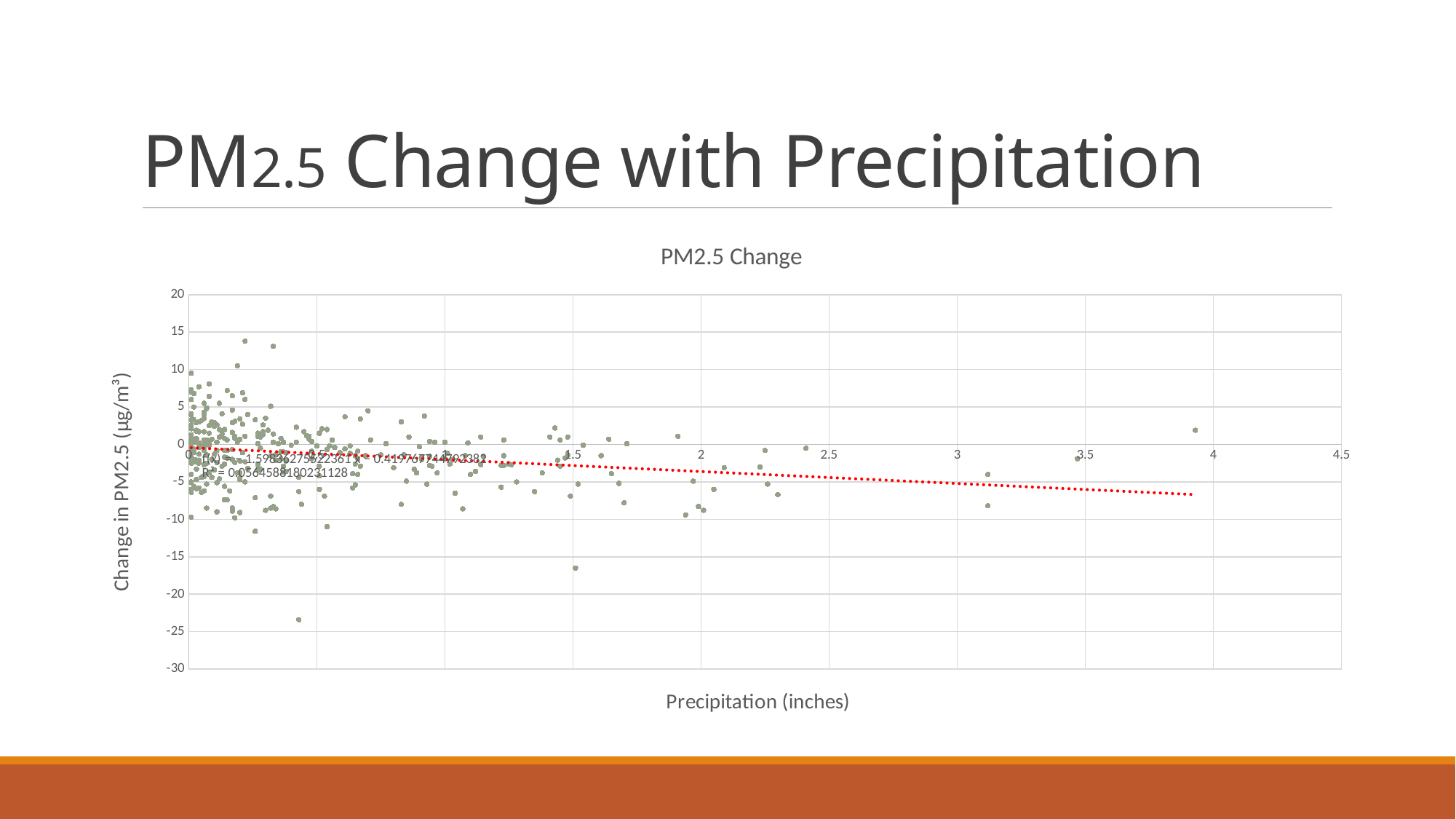
Is the change in PM2.5 for the point with the largest precipitation (near 4 inches) greater or less than 0? greater What is the maximum value shown on the x axis? 4.5 Is the trendline's value at a precipitation of 4 inches greater or less than 0? less Is the highest plotted point's change in PM2.5 greater or less than 10? greater What is the title of the chart? PM2.5 Change What kind of chart is shown on the slide? Scatter plot What is the minimum value shown on the y axis? -30 Does the dotted trendline rise or fall as precipitation increases? Fall